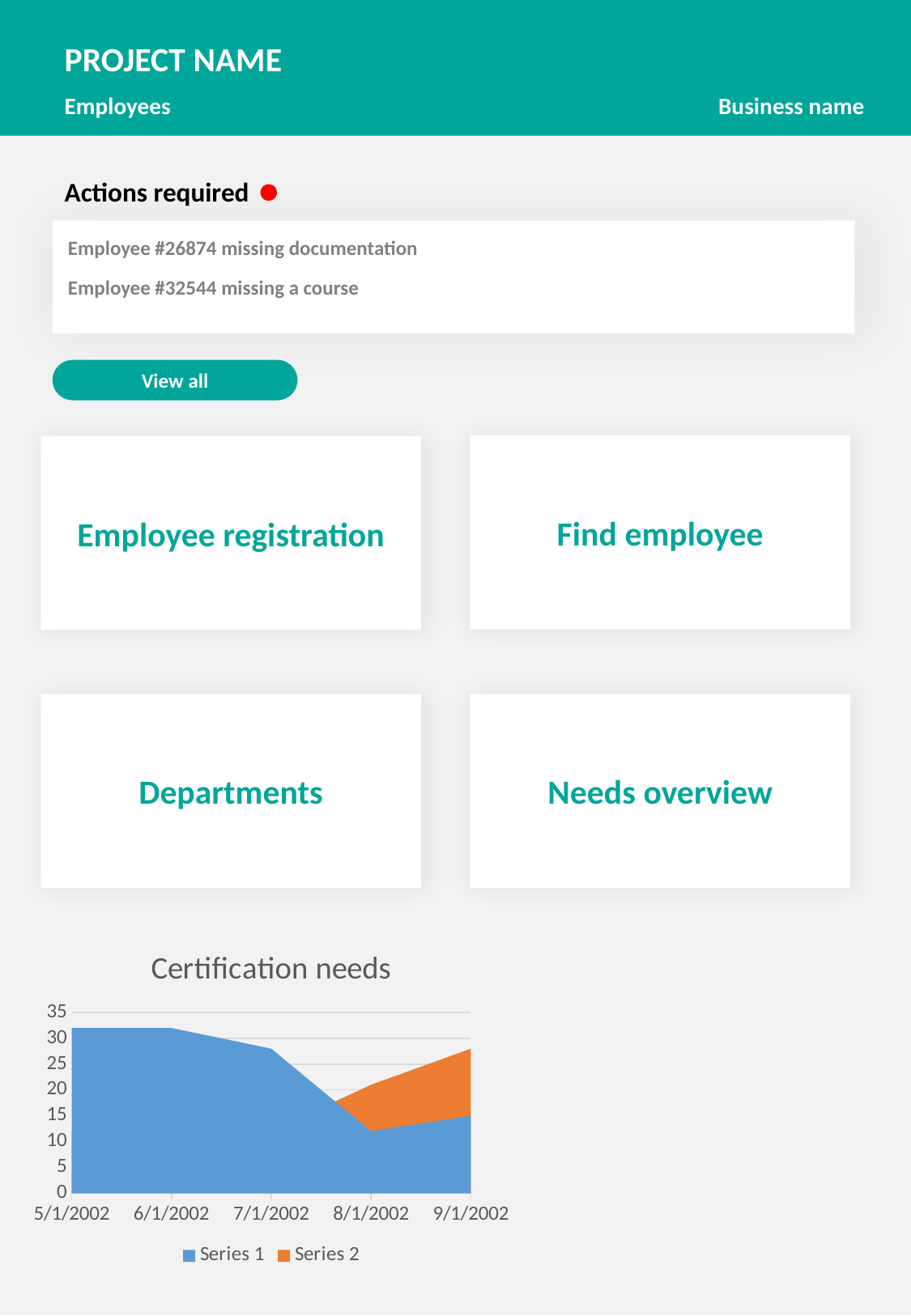
How many dates are shown on the x axis of the Certification needs chart? 5 In the Certification needs chart, is the value for Series 1 at 8/1/2002 greater or less than 15? less What is the title of the chart at the bottom of the slide? Certification needs How many series does the legend of the Certification needs chart list? 2 In the Certification needs chart, does Series 1 rise or fall from 5/1/2002 to 8/1/2002? fall In the Certification needs chart, is the value for Series 1 at 6/1/2002 larger or smaller than at 8/1/2002? larger In the Certification needs chart, is the value for Series 1 at 7/1/2002 greater or less than 25? greater In the Certification needs chart, at which date is Series 1 lowest? 8/1/2002 What kind of chart is shown under the title "Certification needs"? area chart In the Certification needs chart, is the value for Series 1 at 5/1/2002 greater or less than 25? greater In the Certification needs chart, which colour represents Series 2? orange